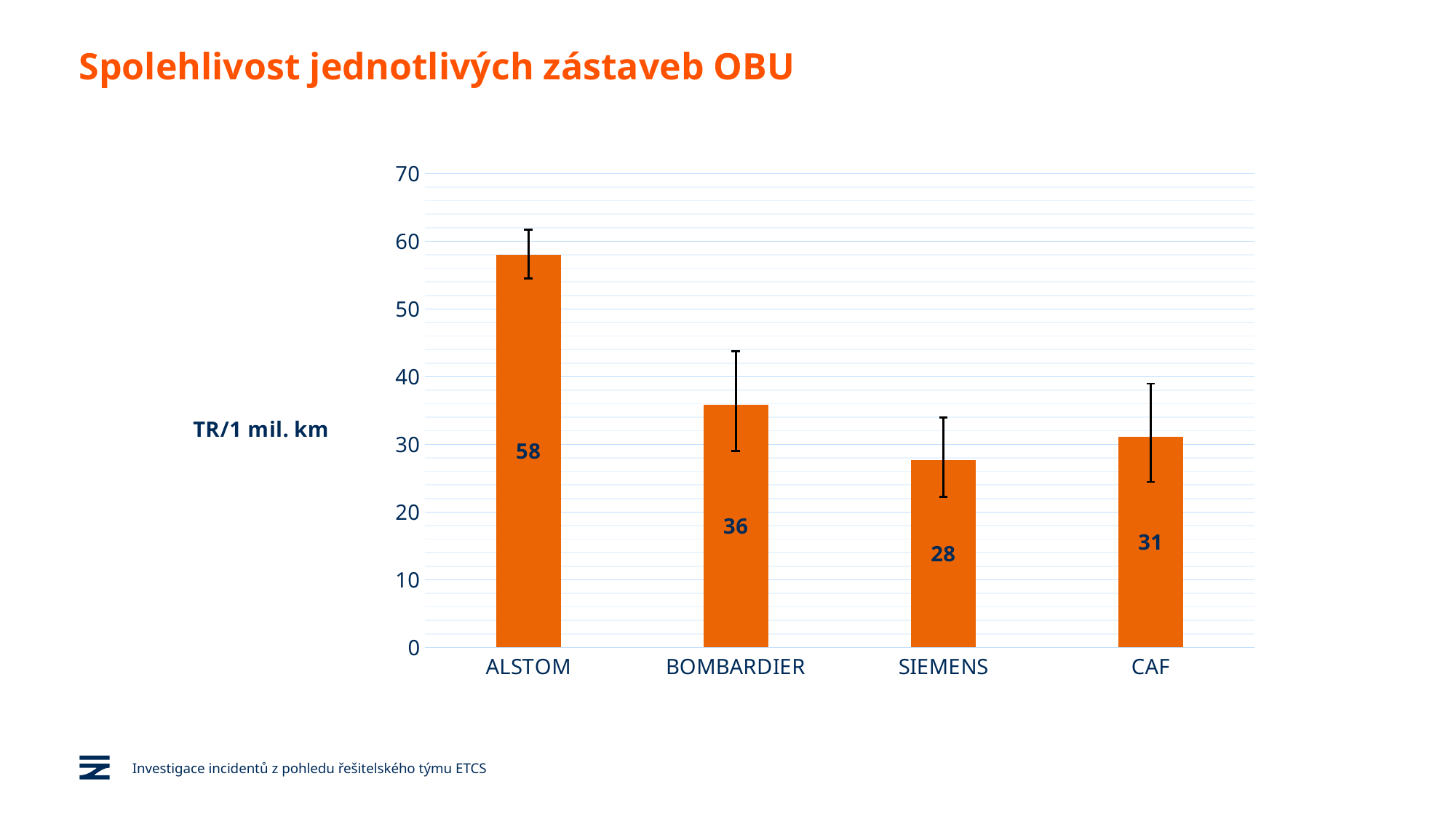
What is the label on the vertical axis of the chart? TR/1 mil. km Which category has the lowest value? SIEMENS What is the value for CAF? 31 What kind of chart is shown on the slide? bar chart What is the value for ALSTOM? 58 How many categories are shown on the chart? 4 Which is larger, the value for CAF or the value for SIEMENS? CAF Which category has the highest value? ALSTOM What is the difference between the values for ALSTOM and BOMBARDIER? 22 What is the value for BOMBARDIER? 36 What is the value for SIEMENS? 28 Is the value for ALSTOM greater or less than 50? greater